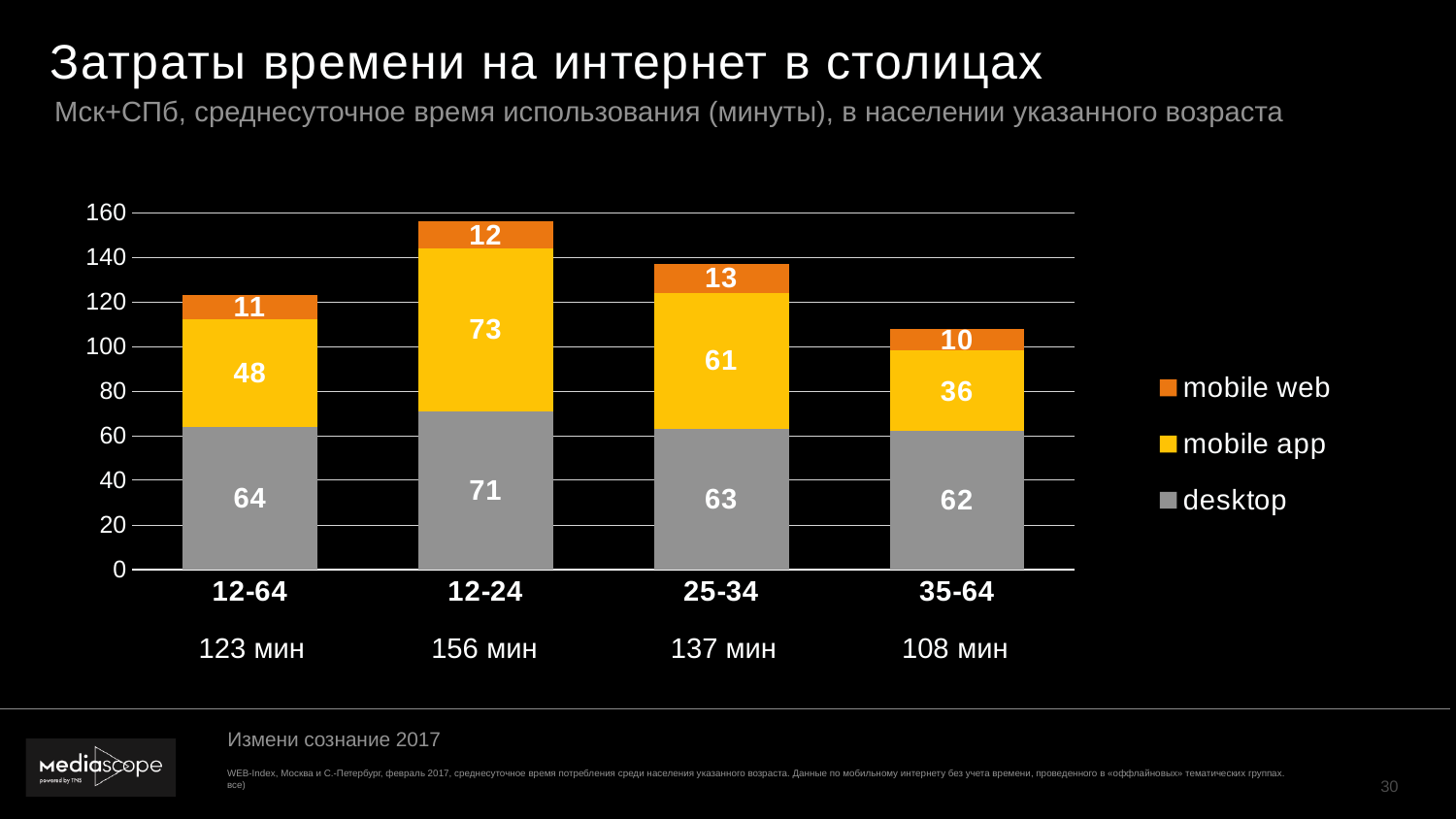
What is the difference between the mobile app values for 12-24 and 35-64? 37 How many series does the legend list? 3 Which age group has the highest mobile app value? 12-24 What is the desktop value for the 12-24 age group? 71 What is the total of the stacked bar for the 12-24 age group? 156 мин What kind of chart is shown on the slide? Stacked bar chart What is the mobile web value for the 35-64 age group? 10 Which age group has the lowest mobile app value? 35-64 Which is larger: the desktop value for 12-64 or the desktop value for 35-64? 12-64 What is the total of the stacked bar for the 35-64 age group? 108 мин How many age groups are shown on the x axis? 4 What is the mobile app value for the 25-34 age group? 61